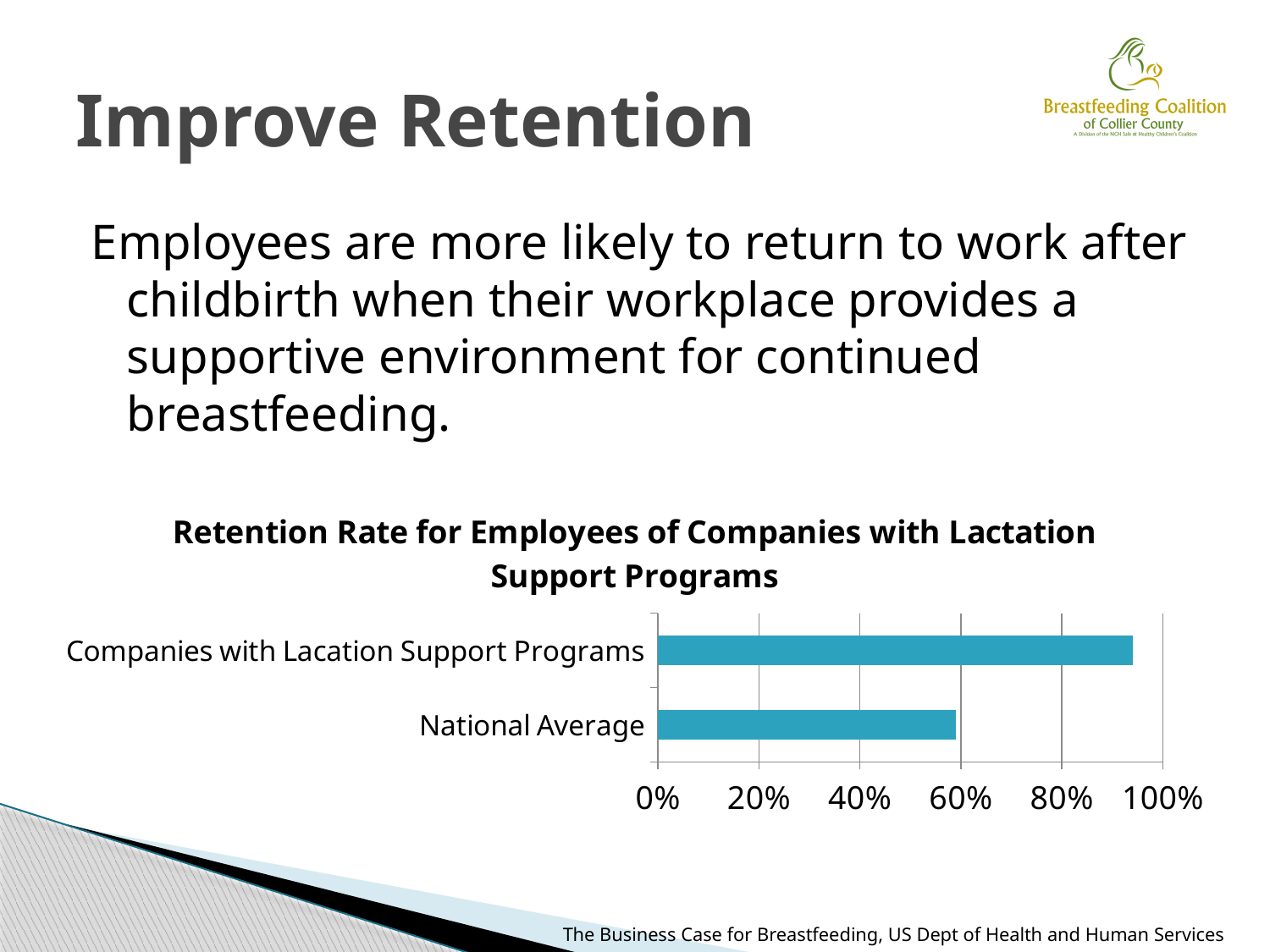
Which category has the lowest retention rate? National Average Which is larger, the value for Companies with Lacation Support Programs or the value for National Average? Companies with Lacation Support Programs What is the highest value shown on the chart's horizontal axis? 100% What kind of chart is shown on the slide? bar chart How many categories does the chart show? 2 What is the title of the chart? Retention Rate for Employees of Companies with Lactation Support Programs Which category has the highest retention rate? Companies with Lacation Support Programs Is the value for Companies with Lacation Support Programs greater or less than 80%? greater Is the value for National Average greater or less than 40%? greater Is the value for National Average greater or less than 80%? less